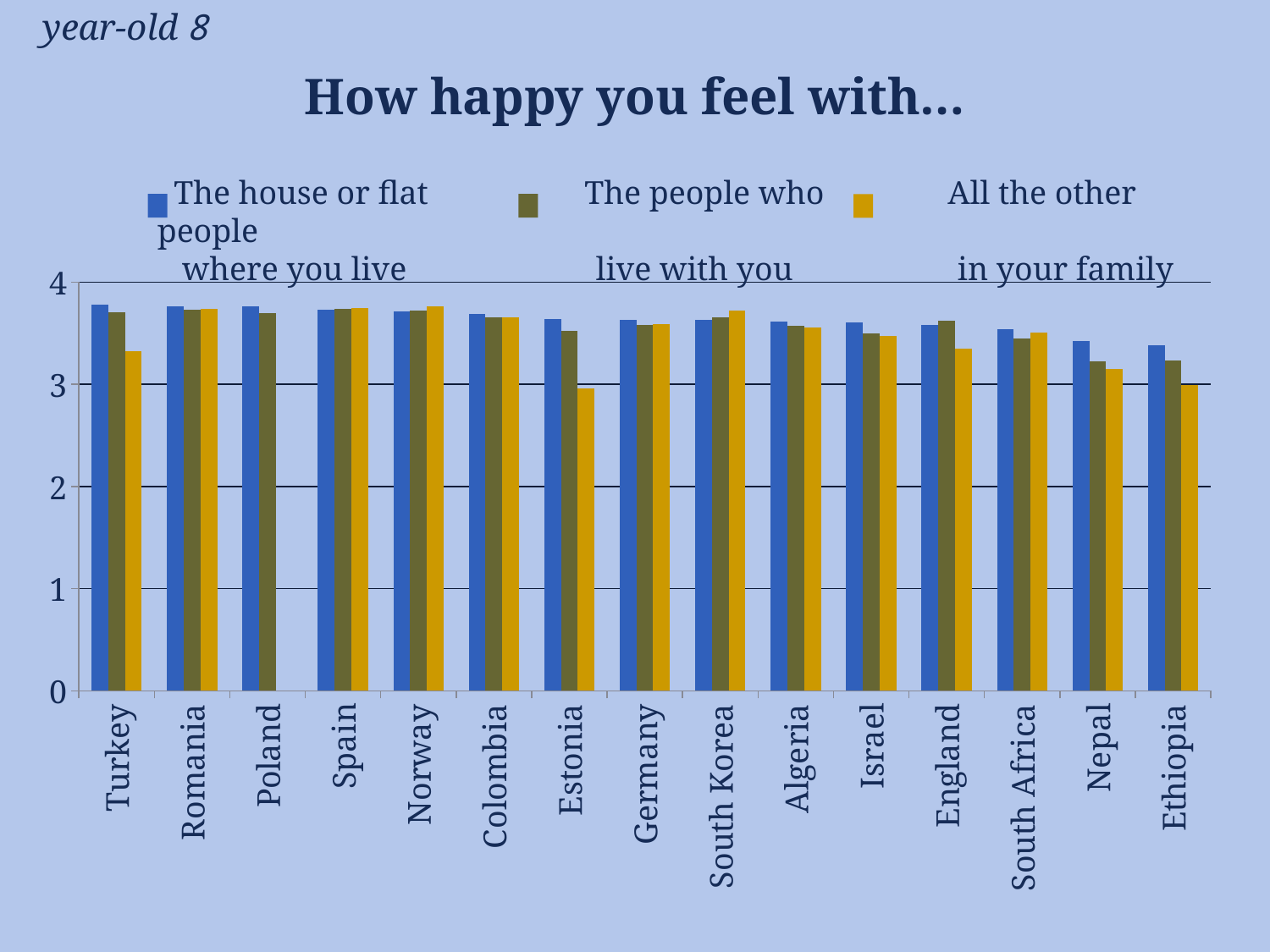
What is the title of the chart? How happy you feel with... What kind of chart is shown on the slide? bar chart Is the value for Ethiopia in the 'The house or flat where you live' series greater or less than 3? greater How many series does the legend list? 3 Is the value for Nepal in the 'The people who live with you' series greater or less than 2? greater Do the values for 'The house or flat where you live' generally rise or fall from Turkey to Ethiopia along the x axis? fall Is the value for Turkey in the 'All the other people in your family' series greater or less than 3? greater Which series is shown in yellow? All the other people in your family How many countries are shown on the x axis of the chart? 15 For Estonia, which is larger: the value for 'The house or flat where you live' or the value for 'All the other people in your family'? The house or flat where you live For Turkey, which is larger: the value for 'The house or flat where you live' or the value for 'All the other people in your family'? The house or flat where you live